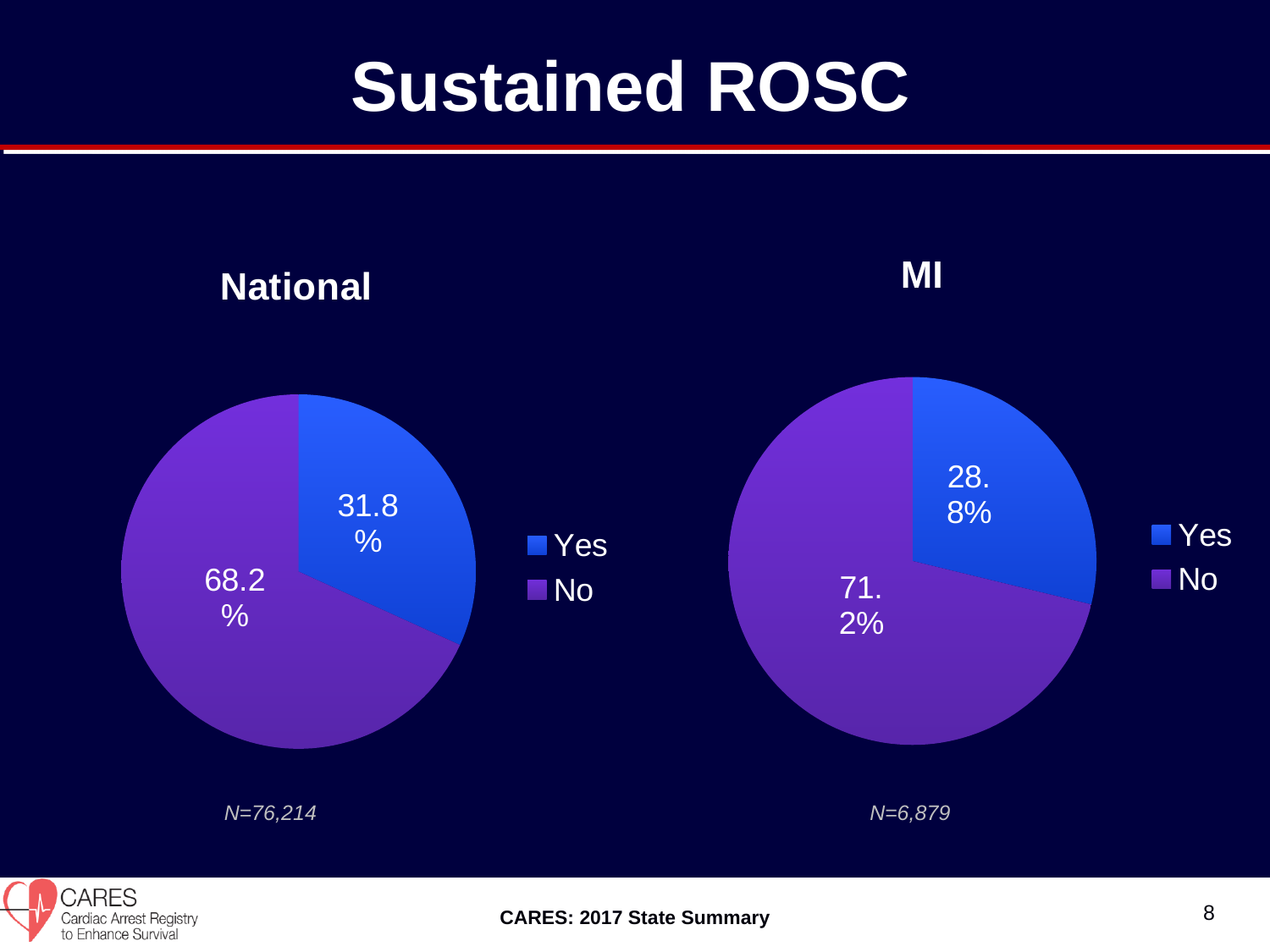
What is the N value shown below the MI pie chart? N=6,879 Is the Yes share larger in the National chart or the MI chart? National What is the difference between the Yes percentage in the National chart and the Yes percentage in the MI chart? 3.0% What is the difference between the No and Yes percentages in the MI pie chart? 42.4% In the MI pie chart, what percentage is shown for No? 71.2% In the National pie chart, which slice is the largest? No How many entries does the legend of the MI chart list? 2 In the MI pie chart, what percentage is shown for Yes? 28.8% What type of chart is used for the National data? Pie chart In the National pie chart, what percentage is shown for No? 68.2% In the National pie chart, what percentage is shown for Yes? 31.8% In the MI pie chart, which slice is the smallest? Yes